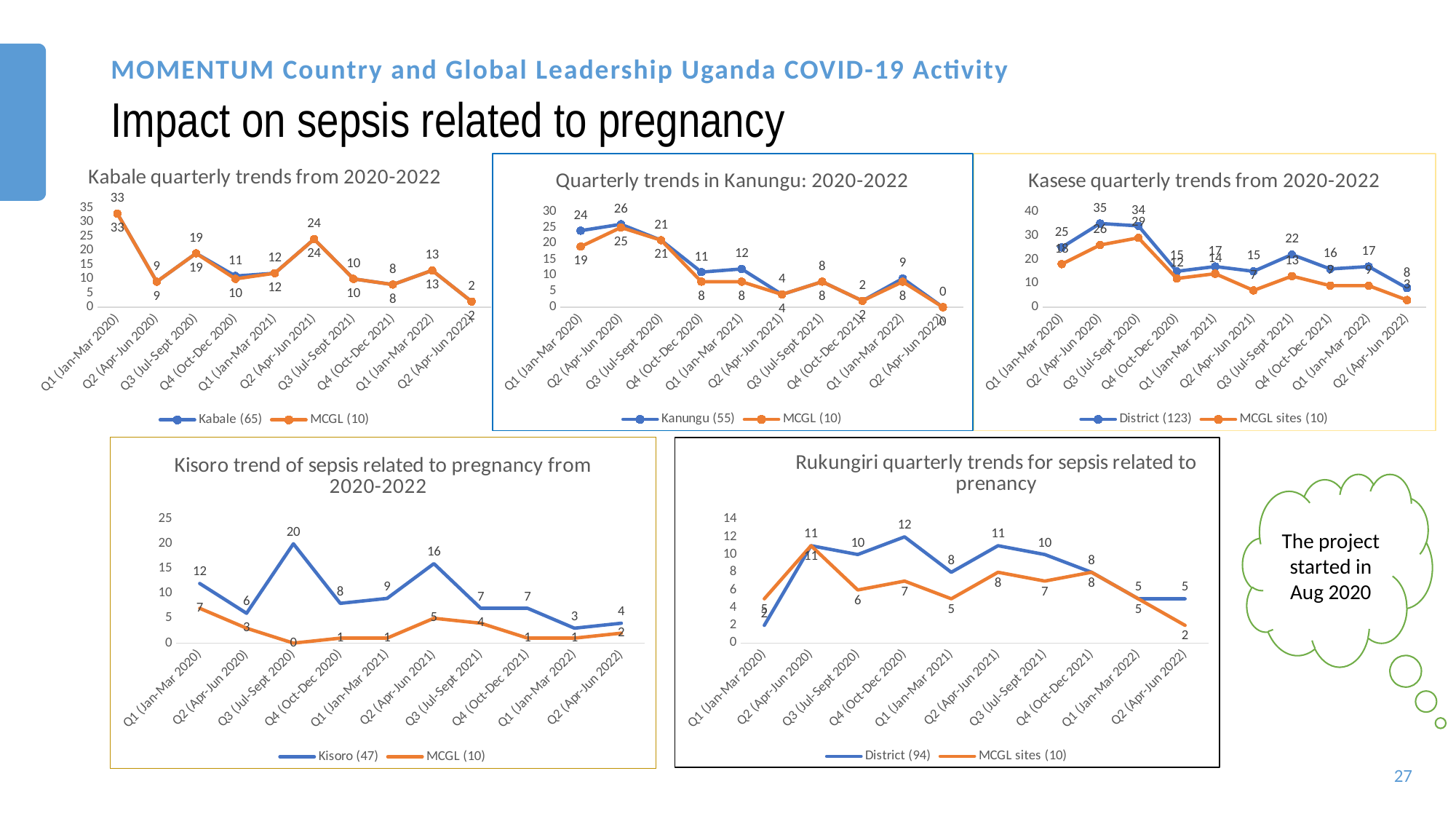
In the Kasese quarterly trends chart, which quarter has the highest value for District (123)? Q2 (Apr-Jun 2020) In the Kabale quarterly trends chart, which quarter has the lowest value for MCGL (10)? Q2 (Apr-Jun 2022) In the Kabale quarterly trends chart, what is the value for Kabale (65) in Q1 (Jan-Mar 2020)? 33 In the Quarterly trends in Kanungu chart, what is the difference between Kanungu (55) and MCGL (10) in Q1 (Jan-Mar 2020)? 5 In the Kasese quarterly trends chart, what is the value for MCGL sites (10) in Q3 (Jul-Sept 2020)? 29 What type of chart is the Kisoro trend of sepsis related to pregnancy chart? Line chart In the Rukungiri quarterly trends chart, what is the value for MCGL sites (10) in Q2 (Apr-Jun 2022)? 2 In the Kisoro trend chart, what is the value for Kisoro (47) in Q3 (Jul-Sept 2020)? 20 In the Rukungiri quarterly trends chart, what is the value for District (94) in Q4 (Oct-Dec 2020)? 12 How many series does the legend of the Kasese quarterly trends chart list? 2 In the Quarterly trends in Kanungu chart, what is the value for Kanungu (55) in Q2 (Apr-Jun 2020)? 26 In the Kisoro trend chart, which series has the larger value in Q2 (Apr-Jun 2021), Kisoro (47) or MCGL (10)? Kisoro (47)